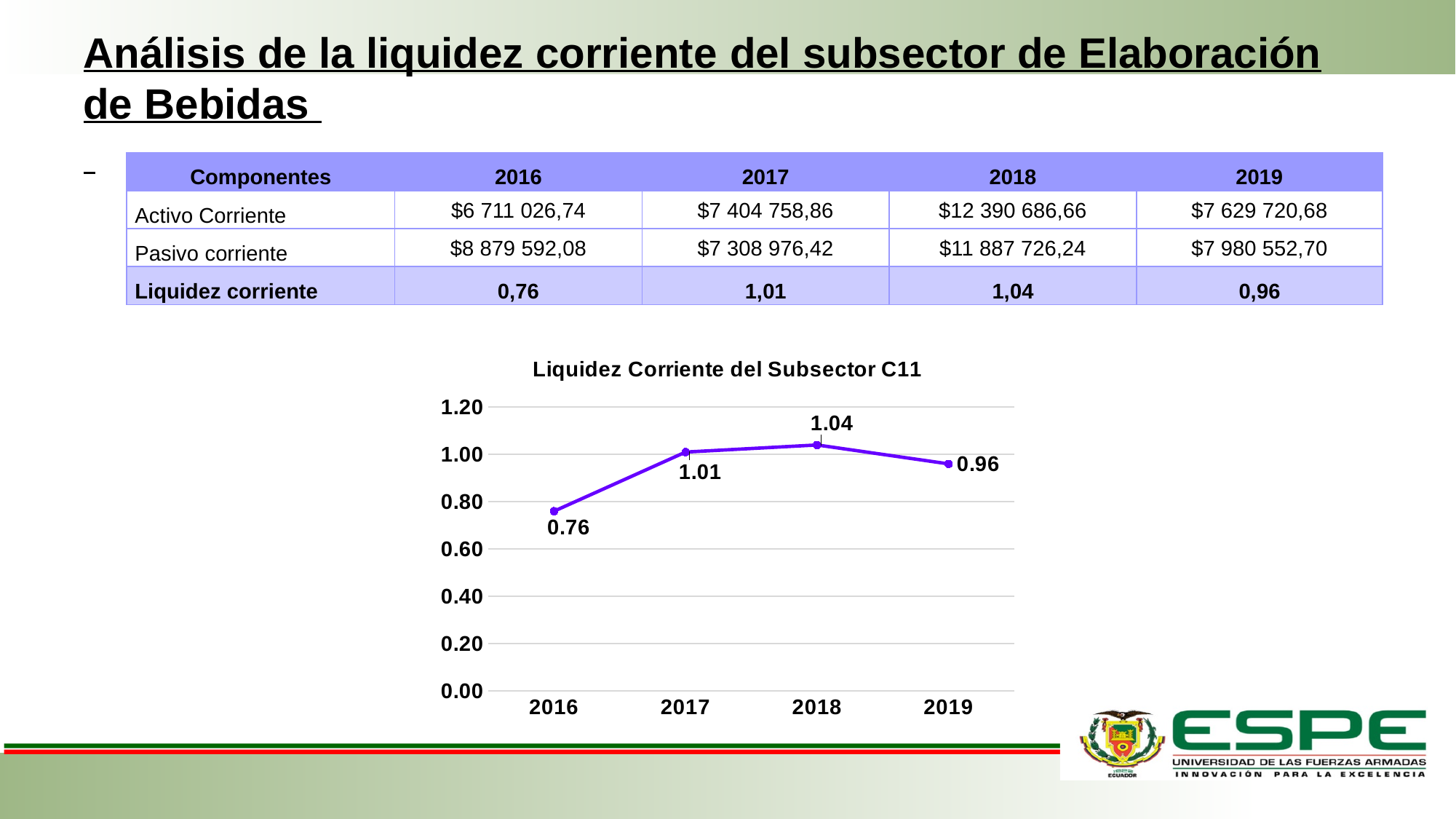
What is the difference between the values for 2017 and 2019? 0.05 What kind of chart is shown on the slide? line chart Which year has the lowest value in the chart? 2016 Is the value for 2016 greater or less than 0.80? less What is the difference between the values for 2018 and 2016? 0.28 What is the value for 2019 in the chart? 0.96 How many years are plotted in the chart? 4 What is the value for 2016 in the chart? 0.76 Which is larger, the value for 2017 or the value for 2019? 2017 Which year has the highest value in the chart? 2018 What is the value for 2018 in the chart? 1.04 What is the title of the chart? Liquidez Corriente del Subsector C11